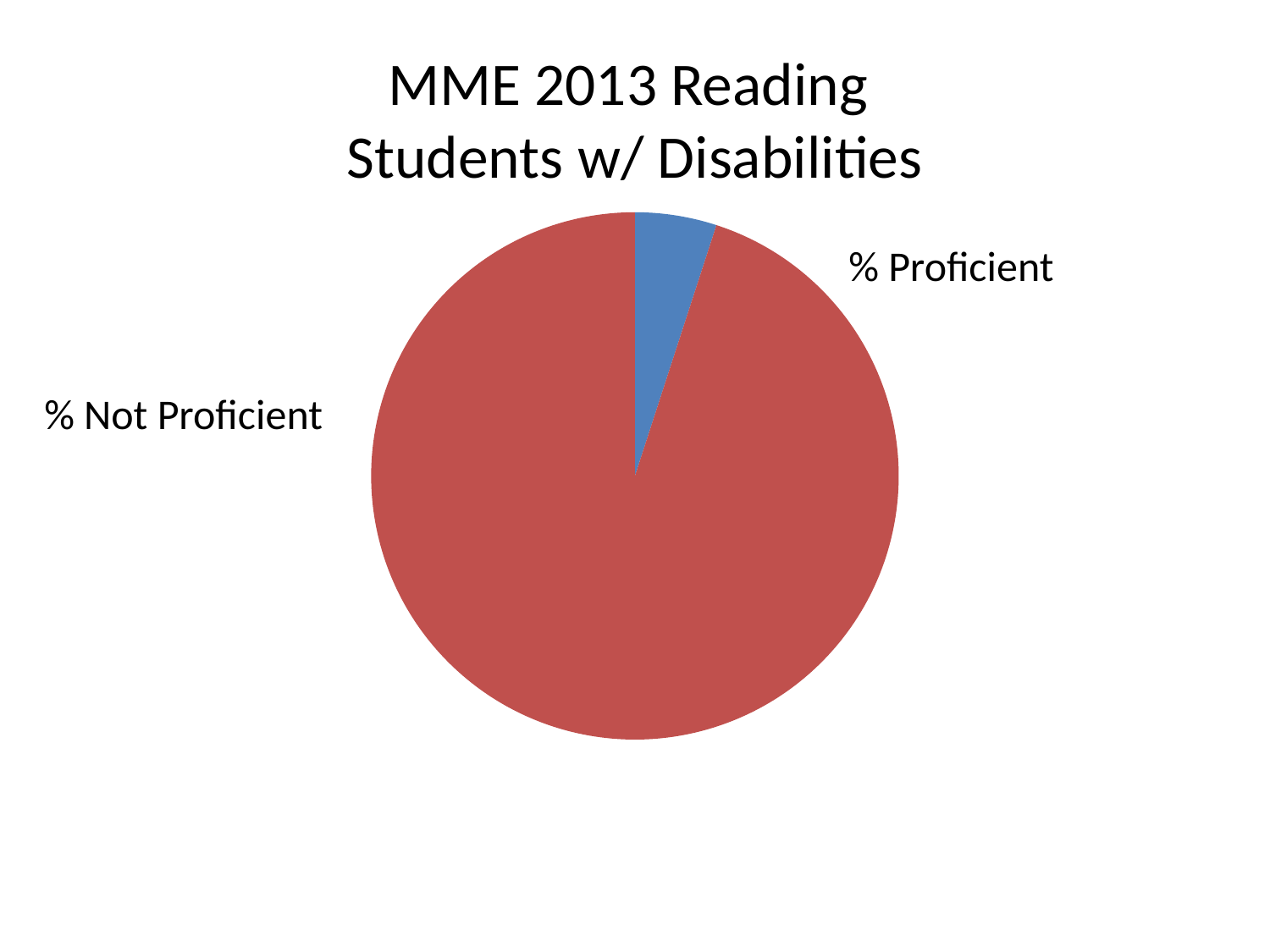
What colour is the % Proficient slice? blue How many slices does the pie chart have? 2 Is the % Not Proficient slice greater or less than half of the pie? greater Which slice is the smallest? % Proficient Which slice is the largest? % Not Proficient What is the title of the chart? MME 2013 Reading Students w/ Disabilities What kind of chart is shown on the slide? pie chart Which is larger, the % Proficient slice or the % Not Proficient slice? % Not Proficient Is the % Proficient slice greater or less than a quarter of the pie? less